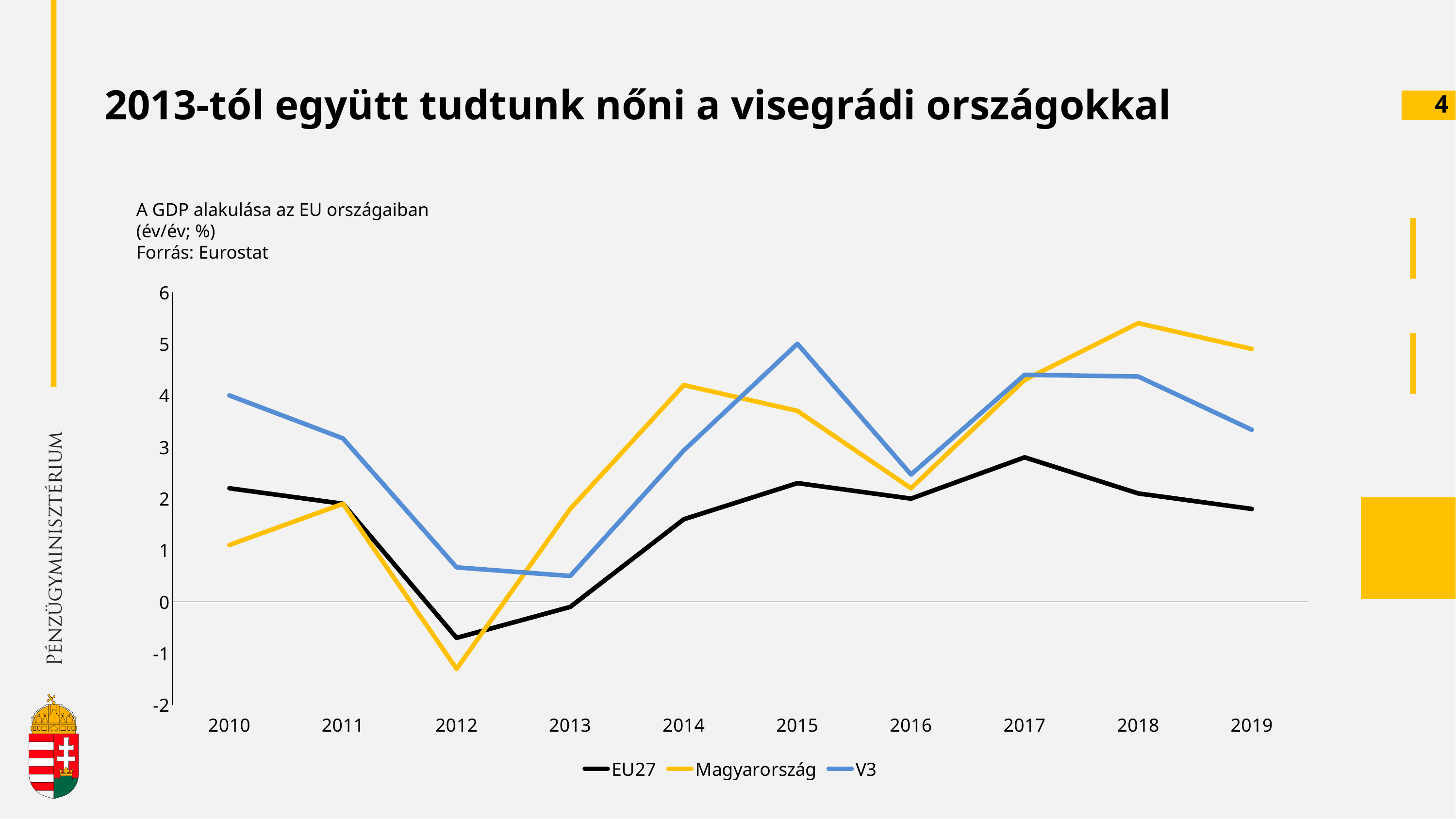
How many years are shown on the x axis? 10 What kind of chart is shown on the slide? line chart Is the value for EU27 in 2012 greater or less than 0? less In which year does Magyarország reach its lowest value? 2012 Which series has the highest value in 2018? Magyarország Is the value for Magyarország in 2012 greater or less than -1? less Does the EU27 line rise or fall from 2017 to 2019? fall In 2015, which is larger: V3 or Magyarország? V3 Is the value for Magyarország in 2018 greater or less than 5? greater How many series does the legend list? 3 In which year does V3 reach its highest value? 2015